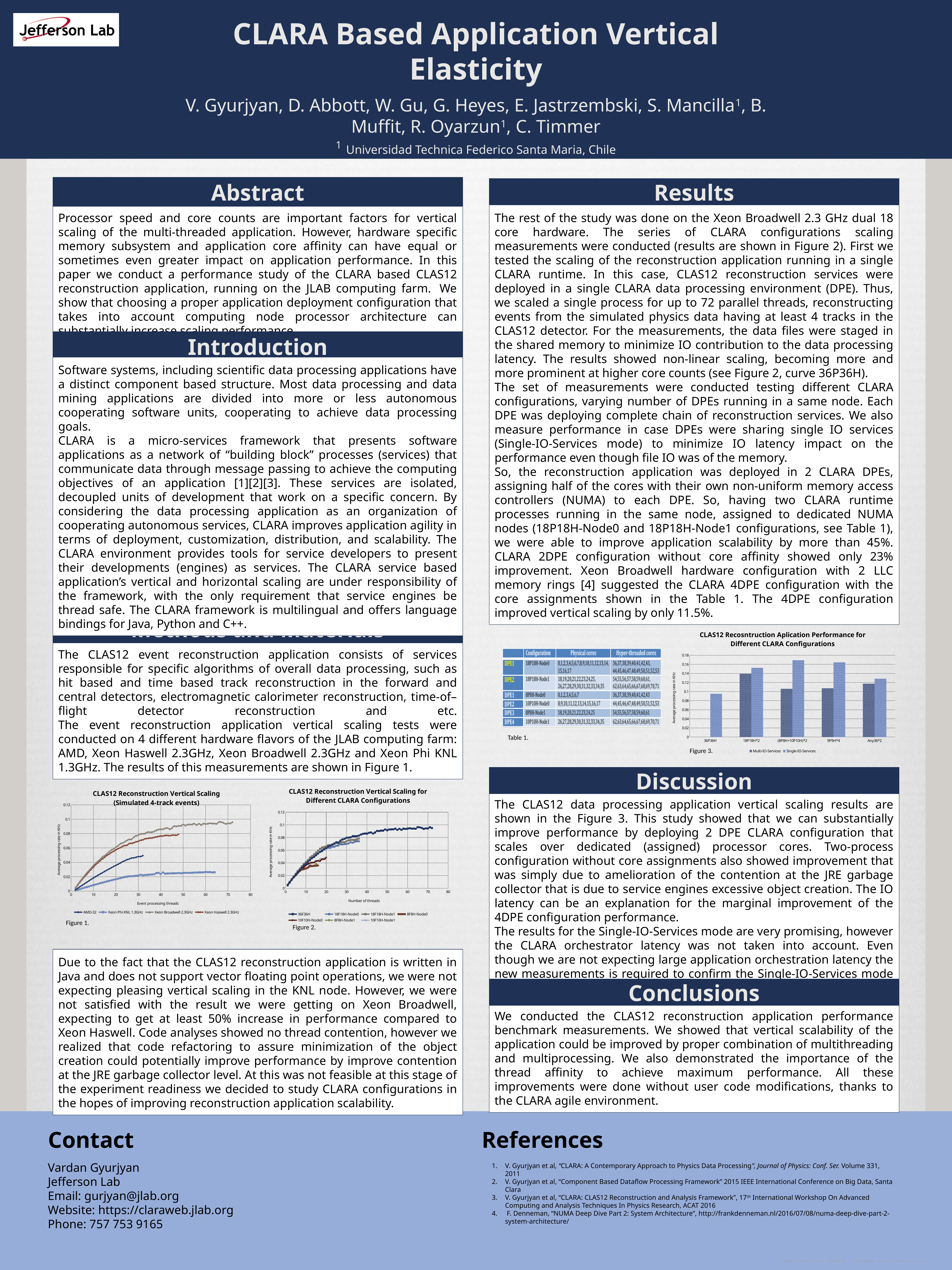
In Figure 1, which hardware series has the lowest processing rate? Xeon Phi KNL 1.3GHz How many CLARA configurations are shown on the x axis of Figure 3? 5 In Figure 3, is the Multi-IO-Services value for 18P18H*2 greater or less than 0.12? greater In Figure 3, is the Single-IO-Services value for (8P8H+10P10H)*2 greater or less than 0.14? greater How many series does the legend of Figure 3 list? 2 What kind of chart is Figure 3, 'CLAS12 Recosntruction Aplication Performance for Different CLARA Configurations'? bar chart How many series does the legend of Figure 1 list? 4 In Figure 3, is the Multi-IO-Services value for 9P9H*4 greater or less than 0.12? less In Figure 3, for the (8P8H+10P10H)*2 configuration, which is larger: Multi-IO-Services or Single-IO-Services? Single-IO-Services How many series does the legend of Figure 2, 'CLAS12 Reconstruction Vertical Scaling for Different CLARA Configurations', list? 7 In Figure 1, which hardware series reaches the highest processing rate? Xeon Broadwell 2.3GHz What kind of chart is Figure 1, 'CLAS12 Reconstruction Vertical Scaling (Simulated 4-track events)'? line chart